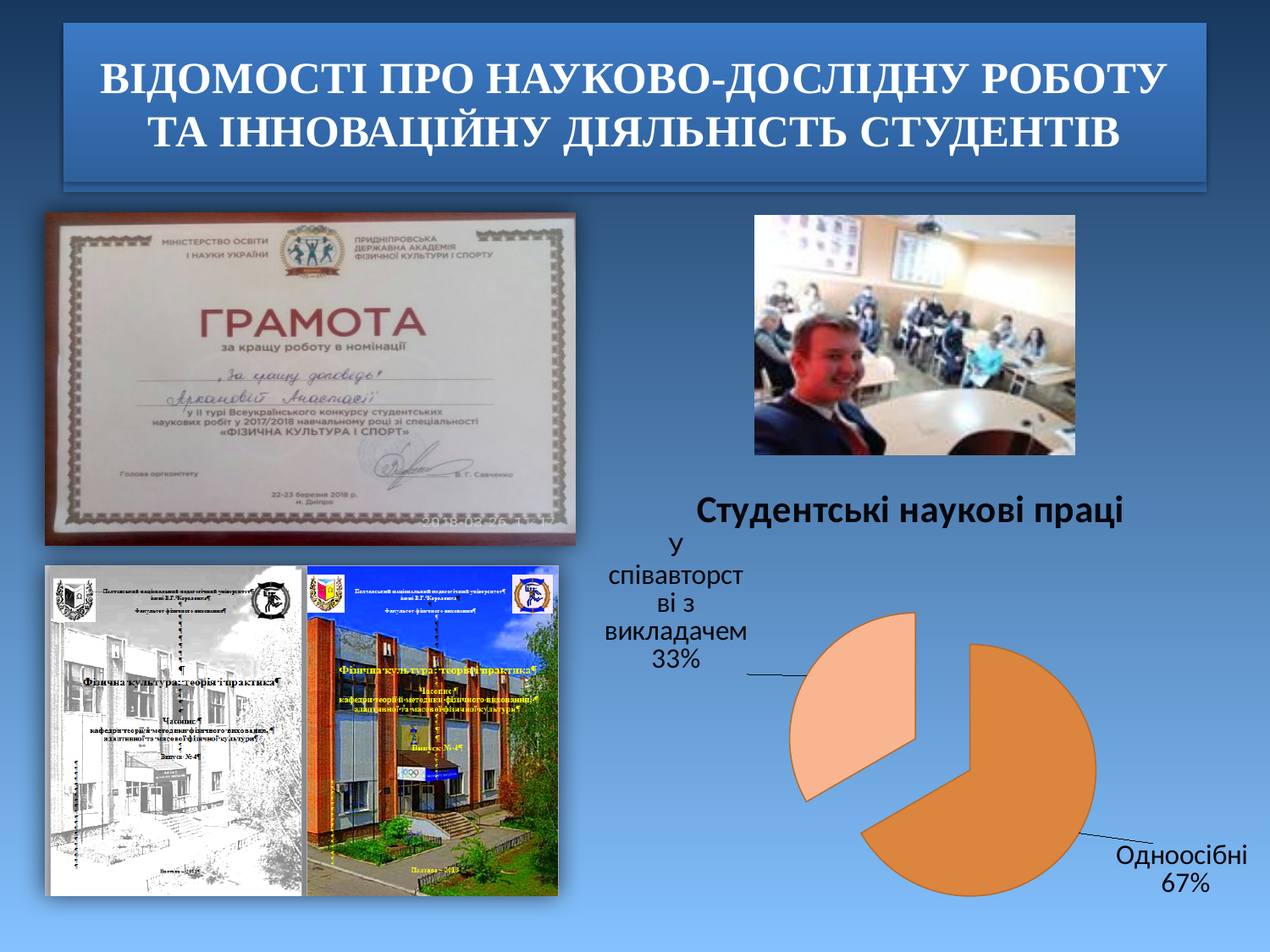
What share of the pie does the slice "У співавторстві з викладачем" represent? 33% What is the difference in percentage points between the "Одноосібні" slice and the "У співавторстві з викладачем" slice? 34 Which slice of the pie chart is drawn in the lighter colour and pulled out from the rest of the pie? У співавторстві з викладачем What share of the pie does the slice "Одноосібні" represent? 67% How many slices does the pie chart have? 2 Which is larger: the share for "Одноосібні" or the share for "У співавторстві з викладачем"? Одноосібні Is the share for "У співавторстві з викладачем" greater or less than 50%? less What kind of chart is shown on the slide? pie chart Is the share for "Одноосібні" greater or less than 50%? greater Which slice of the pie chart is the largest? Одноосібні What is the title of the chart on the slide? Студентські наукові праці Which slice of the pie chart is the smallest? У співавторстві з викладачем